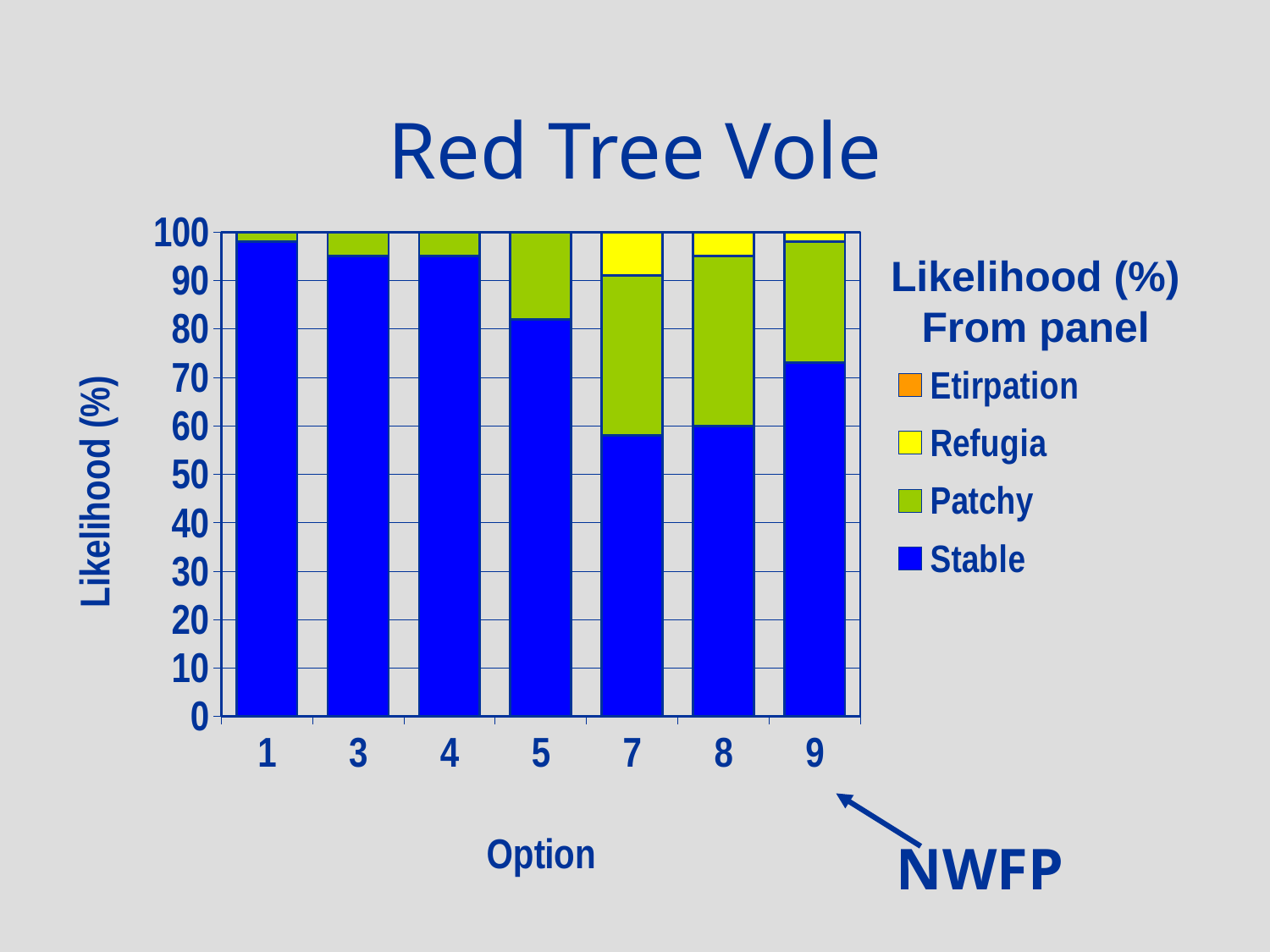
Which has a larger Patchy segment, option 1 or option 9? option 9 How many options are shown along the x axis? 7 Is the Stable value for option 1 greater or less than 90? greater Which option is labelled with the arrow marked NWFP? 9 Which has a larger Stable value, option 5 or option 9? option 5 What kind of chart is shown on the slide? stacked bar chart How many series does the legend list? 4 Is the Stable value for option 7 greater or less than 70? less From option 1 to option 7, does the Stable value rise or fall? fall Is the Stable value for option 5 greater or less than 90? less Which has a larger Stable value, option 1 or option 7? option 1